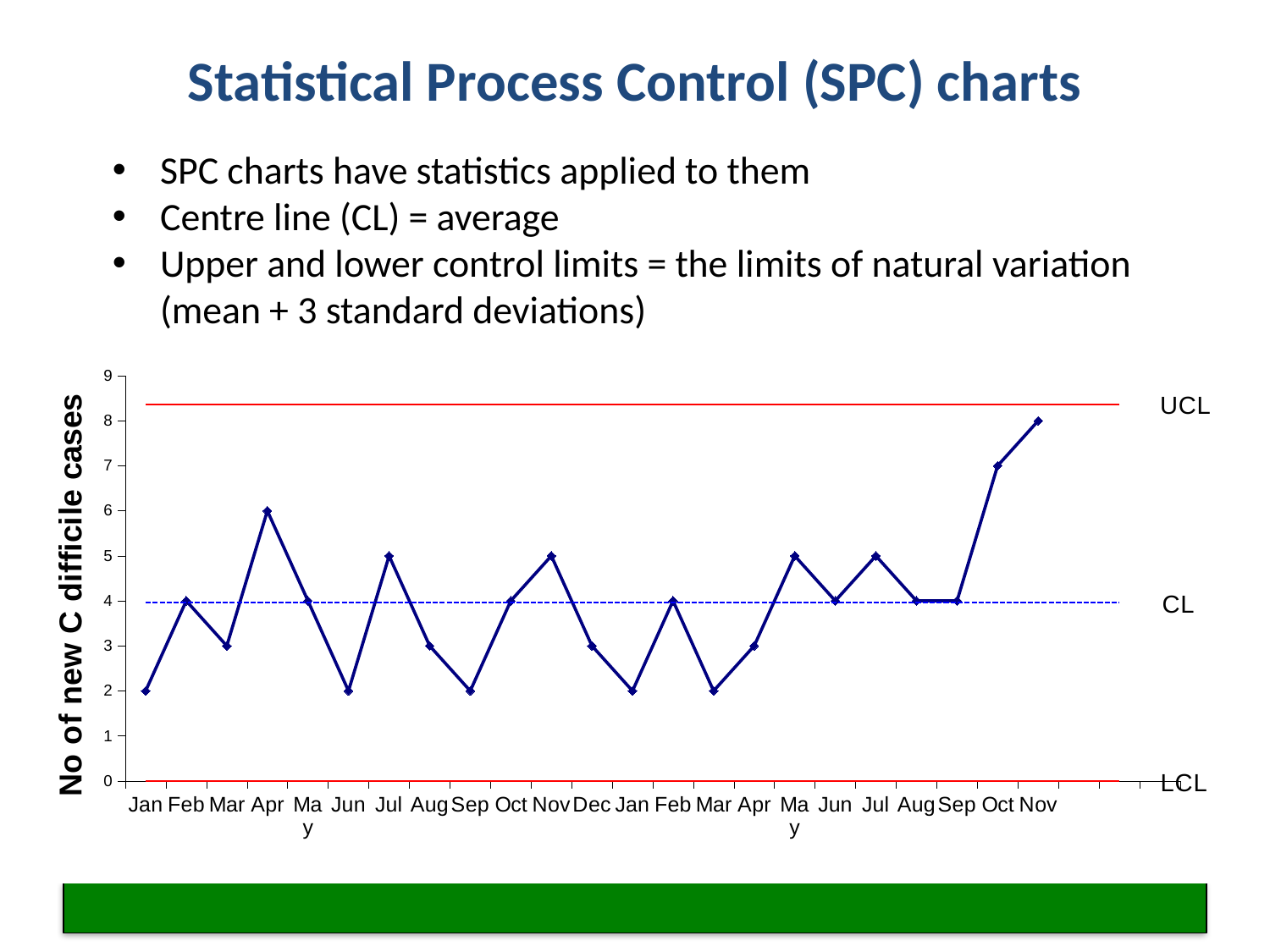
What is the value for the first Jan on the x axis? 2 What is the label on the y axis of the chart? No of new C difficile cases What is the difference between the value for the second Nov and the value for the second Oct? 1 What is the value for the second Oct on the x axis? 7 What type of chart is shown on the slide? line chart Which month has the highest number of new C difficile cases? the second Nov (last point) Is the value for the second Oct greater or less than 5? greater What is the value for the second Nov (the last point) on the x axis? 8 How many data points are plotted on the line? 23 What is the lowest value plotted on the chart? 2 Which is larger, the value for the first Apr or the value for the first Jul? the first Apr What is the value for the first Apr on the x axis? 6